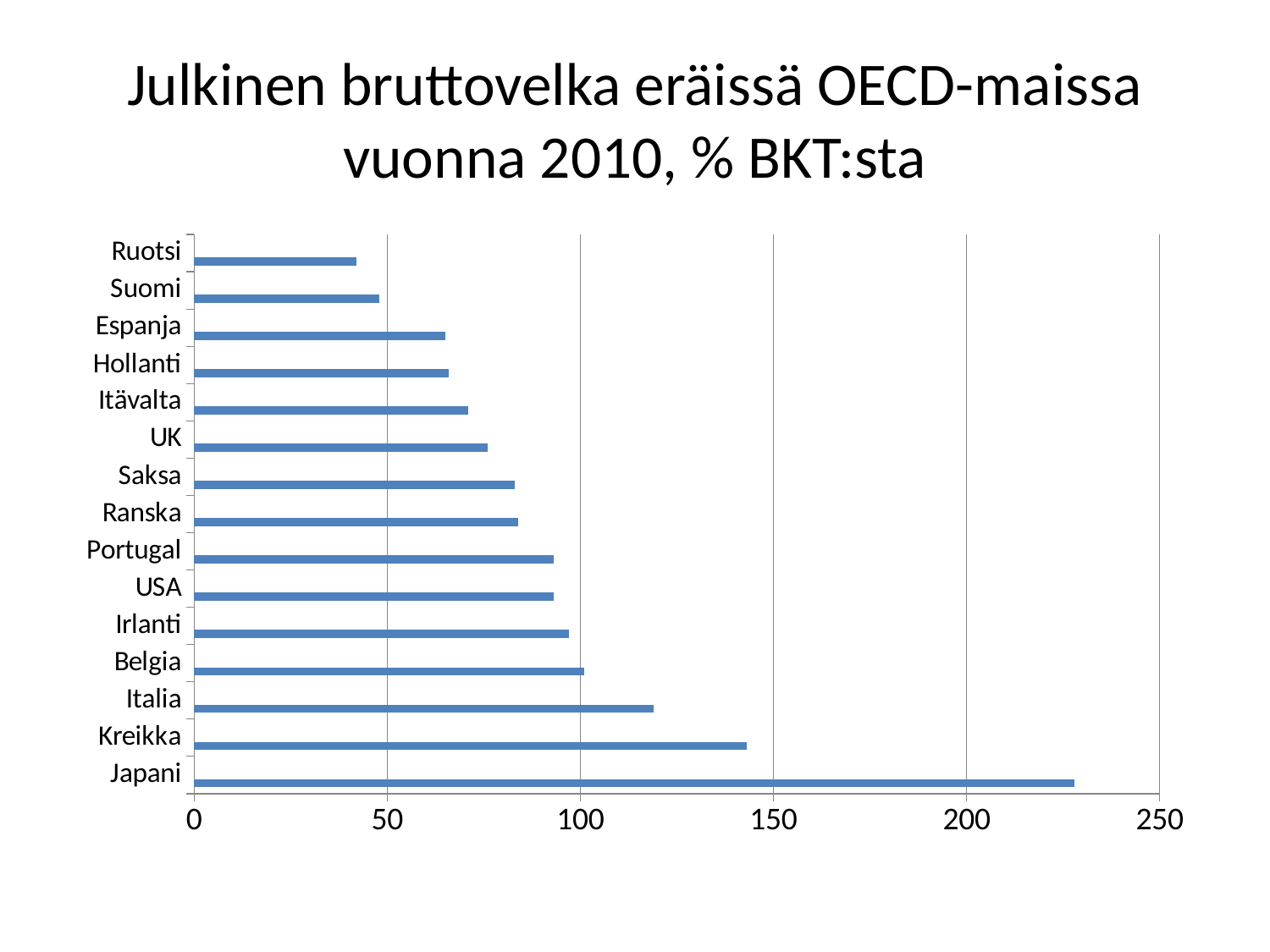
Which has a larger value, Suomi or Ruotsi? Suomi Is the value for Italia greater or less than 100? greater Is the value for Ruotsi greater or less than 50? less What is the title of the chart? Julkinen bruttovelka eräissä OECD-maissa vuonna 2010, % BKT:sta Is the value for Kreikka greater or less than 150? less How many countries are shown in the chart? 15 Which country has the lowest public gross debt in the chart? Ruotsi What kind of chart is shown on the slide? bar chart Which country has the highest public gross debt in the chart? Japani Which has a larger value, Kreikka or Italia? Kreikka